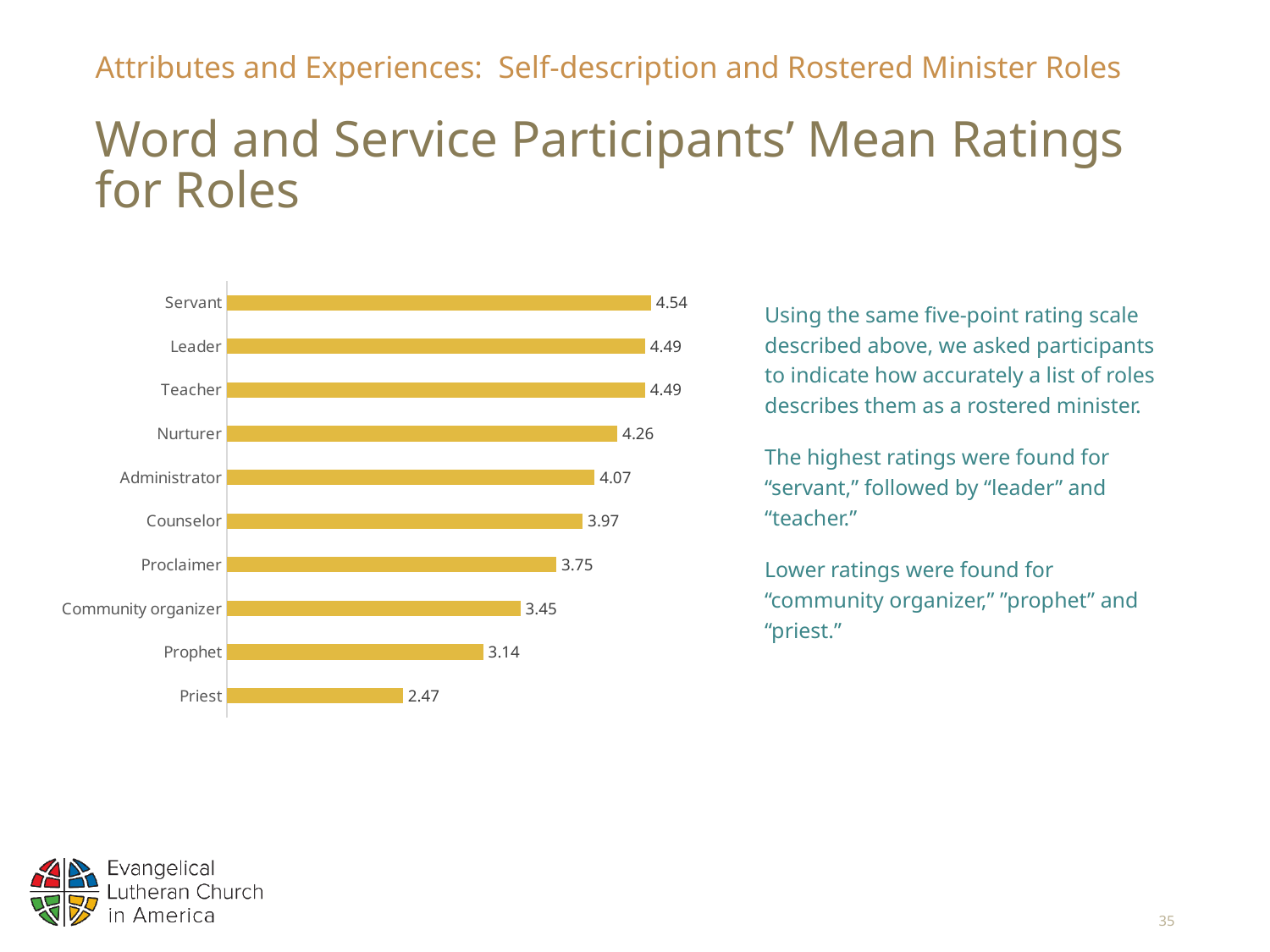
What kind of chart is shown on the slide? Bar chart Which role has the highest mean rating? Servant Which has a higher mean rating, Proclaimer or Prophet? Proclaimer How many roles are shown in the chart? 10 What is the mean rating for Community organizer? 3.45 Which role has the lowest mean rating? Priest What is the mean rating for Administrator? 4.07 What is the title of the chart on the slide? Word and Service Participants' Mean Ratings for Roles What is the mean rating for Servant? 4.54 What is the difference between the mean ratings for Servant and Priest? 2.07 What is the difference between the mean ratings for Nurturer and Counselor? 0.29 Do the mean ratings increase or decrease going down the chart from Servant to Priest? Decrease